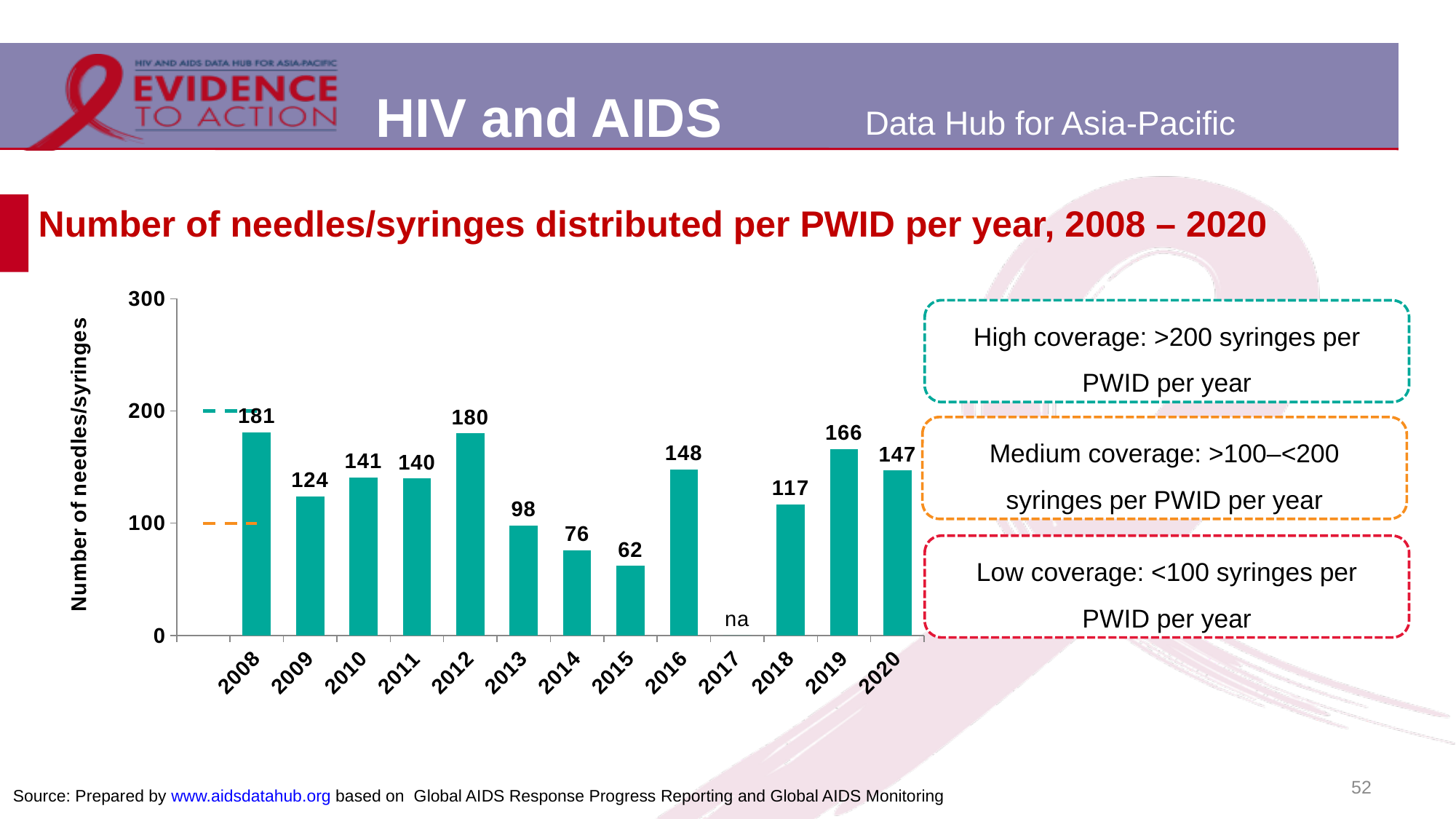
What is the value shown for 2015? 62 Which year has the lowest number of needles/syringes distributed per PWID? 2015 What is the number of needles/syringes distributed per PWID per year in 2008? 181 Is the value for 2018 greater or less than 100? greater Do the values rise or fall from 2012 to 2015? Fall What kind of chart is shown on the slide? Bar chart How many years are shown on the x axis? 13 Which year is marked 'na' instead of a bar? 2017 What is the value shown for 2019? 166 What is the difference between the values for 2012 and 2013? 82 Which year has the highest number of needles/syringes distributed per PWID? 2008 Which year has a larger value, 2016 or 2020? 2016